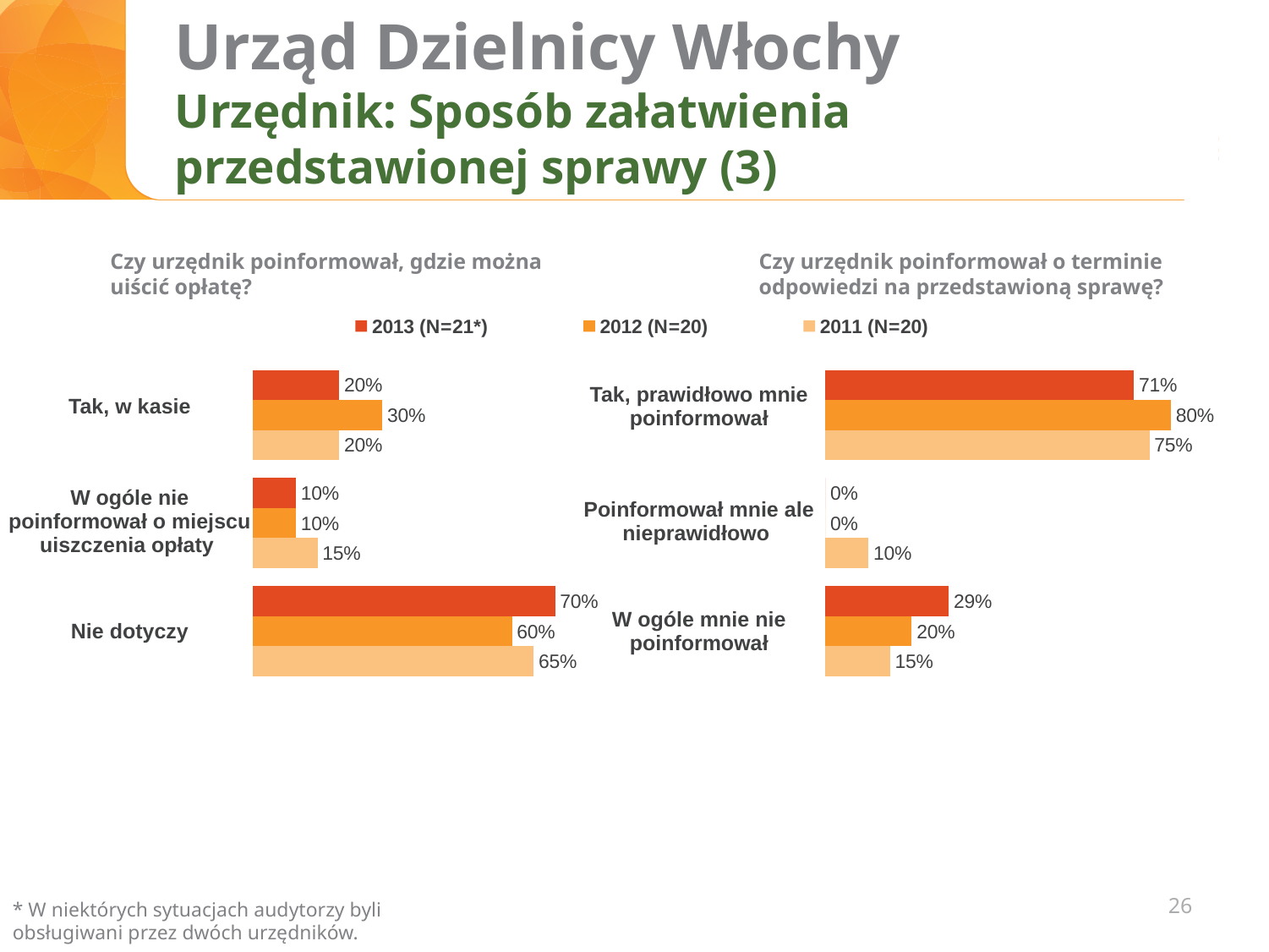
In the left chart ('Czy urzędnik poinformował, gdzie można uiścić opłatę?'), what is the difference between the 2013 and 2012 values for 'Nie dotyczy'? 10% In the left chart ('Czy urzędnik poinformował, gdzie można uiścić opłatę?'), which category has the highest value for 2011 (N=20)? Nie dotyczy In the right chart ('Czy urzędnik poinformował o terminie odpowiedzi na przedstawioną sprawę?'), which is larger for 'W ogóle mnie nie poinformował': the 2012 value or the 2011 value? 2012 (N=20) How many categories does the left chart ('Czy urzędnik poinformował, gdzie można uiścić opłatę?') show? 3 In the right chart ('Czy urzędnik poinformował o terminie odpowiedzi na przedstawioną sprawę?'), which year has the lowest value for 'Tak, prawidłowo mnie poinformował'? 2013 (N=21*) In the right chart ('Czy urzędnik poinformował o terminie odpowiedzi na przedstawioną sprawę?'), what is the difference between the 2012 and 2013 values for 'Tak, prawidłowo mnie poinformował'? 9% In the left chart ('Czy urzędnik poinformował, gdzie można uiścić opłatę?'), what is the value for 'Tak, w kasie' in 2012 (N=20)? 30% In the right chart ('Czy urzędnik poinformował o terminie odpowiedzi na przedstawioną sprawę?'), what is the value for 'W ogóle mnie nie poinformował' in 2013 (N=21*)? 29% In the left chart ('Czy urzędnik poinformował, gdzie można uiścić opłatę?'), what is the value for 'Nie dotyczy' in 2013 (N=21*)? 70% What kind of chart is the right chart ('Czy urzędnik poinformował o terminie odpowiedzi na przedstawioną sprawę?')? Bar chart How many series does the legend list? 3 In the right chart ('Czy urzędnik poinformował o terminie odpowiedzi na przedstawioną sprawę?'), what is the value for 'Tak, prawidłowo mnie poinformował' in 2011 (N=20)? 75%